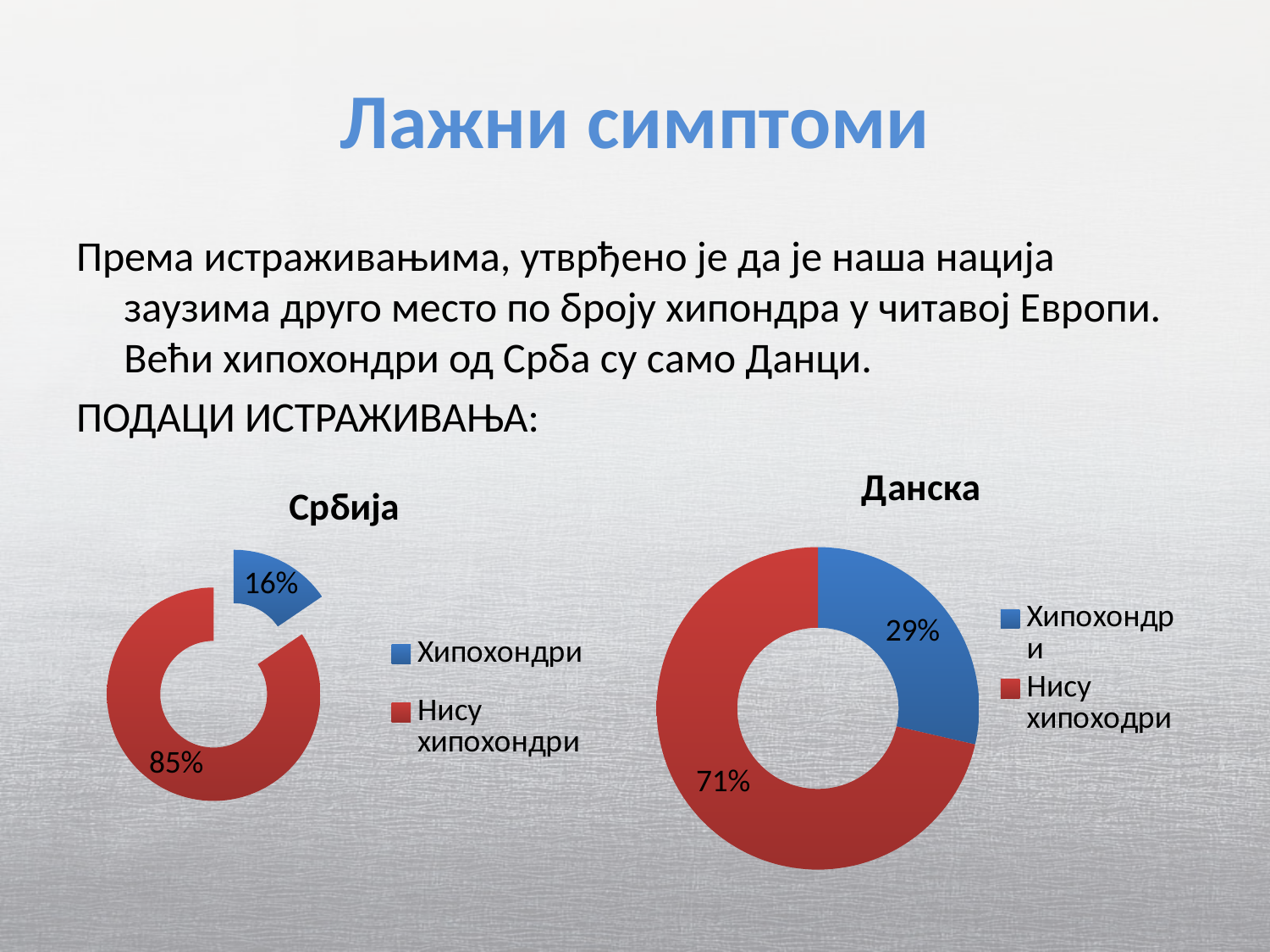
In the Данска chart, which category has the largest share? Нису хипоходри In the Србија chart, what percentage is shown for Хипохондри? 16% In the Данска chart, what percentage is shown for Хипохондри? 29% In the Данска chart, what percentage is shown for Нису хипоходри? 71% In the Србија chart, what is the difference in percentage points between Нису хипохондри and Хипохондри? 69 In the Србија chart, which category has the smallest share? Хипохондри Which chart shows a larger share for Хипохондри, Србија or Данска? Данска In the Србија chart, what colour is the Хипохондри slice? blue In the Данска chart, what is the difference in percentage points between Нису хипоходри and Хипохондри? 42 In the Србија chart, what percentage is shown for Нису хипохондри? 85% What kind of chart is the Србија chart? doughnut chart How many categories does the Данска chart show? 2